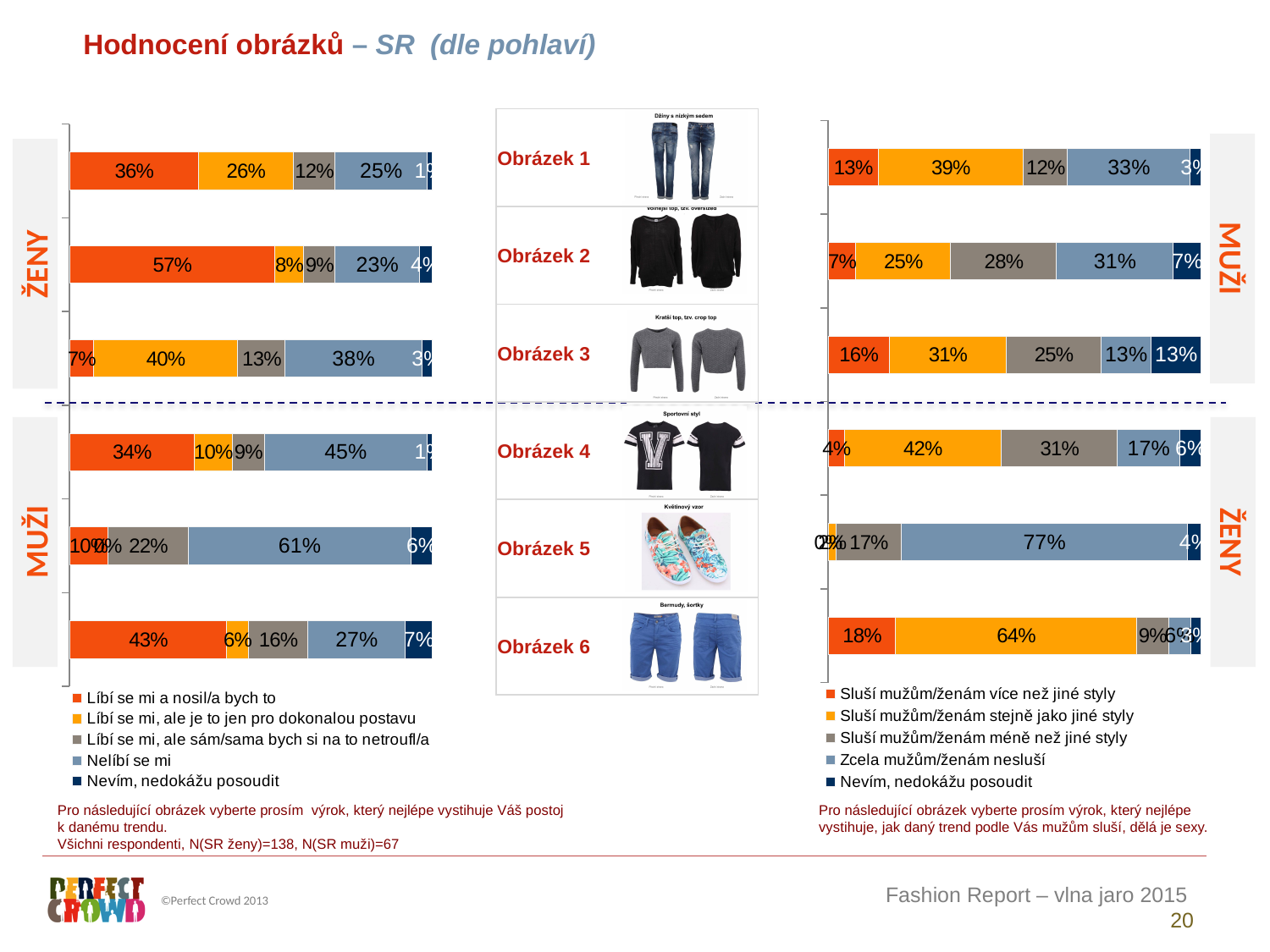
In the right chart, what percentage of women chose 'Sluší mužům/ženám stejně jako jiné styly' for Obrázek 6? 64% In the left chart, among the men's rows (Obrázek 4–6), which picture has the highest share of 'Nelíbí se mi'? Obrázek 5 In the right chart, what percentage of women chose 'Zcela mužům/ženám nesluší' for Obrázek 5? 77% How many pictures (Obrázek) are evaluated on the slide? 6 In the left chart, among the women's rows (Obrázek 1–3), which picture has the highest share of 'Líbí se mi a nosil/a bych to'? Obrázek 2 What kind of chart is used on the left side of the slide? Stacked bar chart In the right chart, which is larger for Obrázek 3 among men: 'Sluší mužům/ženám stejně jako jiné styly' or 'Sluší mužům/ženám méně než jiné styly'? Sluší mužům/ženám stejně jako jiné styly In the left chart, what percentage of women chose 'Líbí se mi a nosil/a bych to' for Obrázek 2? 57% In the right chart, what percentage of men chose 'Sluší mužům/ženám stejně jako jiné styly' for Obrázek 1? 39% In the left chart, what is the difference between the 'Líbí se mi a nosil/a bych to' share for Obrázek 2 (57%) and Obrázek 1 (36%) among women? 21% In the left chart, what percentage of men chose 'Nelíbí se mi' for Obrázek 5? 61% How many series does the legend of the left chart list? 5